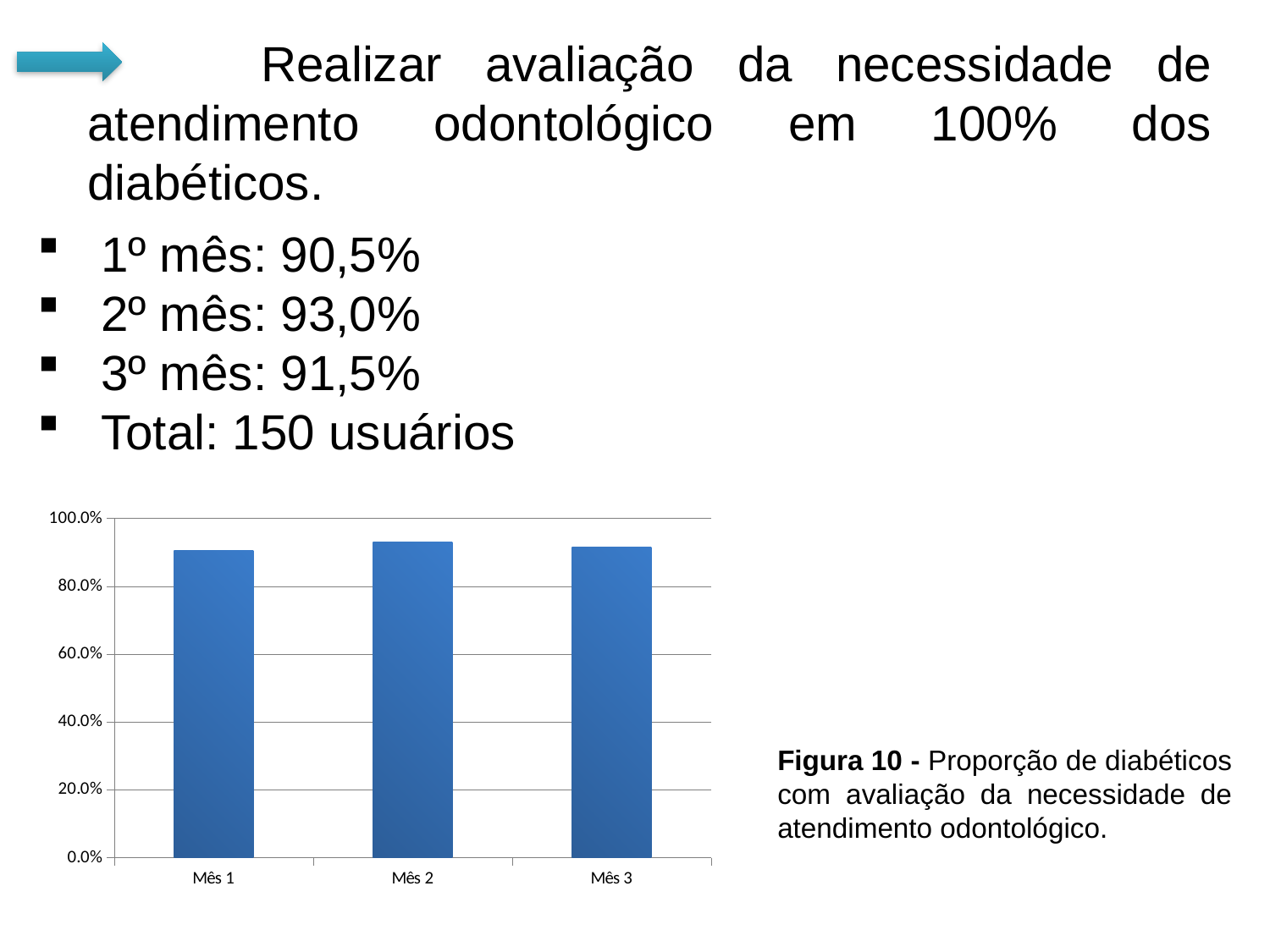
Is the value for Mês 1 greater or less than 80.0%? greater What is the figure number given in the caption of the chart? Figura 10 Is the value for Mês 3 greater or less than 60.0%? greater What kind of chart is shown on the slide? bar chart Which is larger, the value for Mês 2 or the value for Mês 1? Mês 2 According to the slide, what is the proportion for the 2º mês (Mês 2)? 93,0% According to the slide, what is the proportion for the 1º mês (Mês 1)? 90,5% Do the values rise steadily, fall steadily, or rise then fall from Mês 1 to Mês 3? rise then fall How many categories (months) are plotted on the x axis of the chart? 3 What are the category labels on the x axis of the chart? Mês 1, Mês 2, Mês 3 Is the value for Mês 2 greater or less than 100.0%? less Which month has the highest bar in the chart? Mês 2